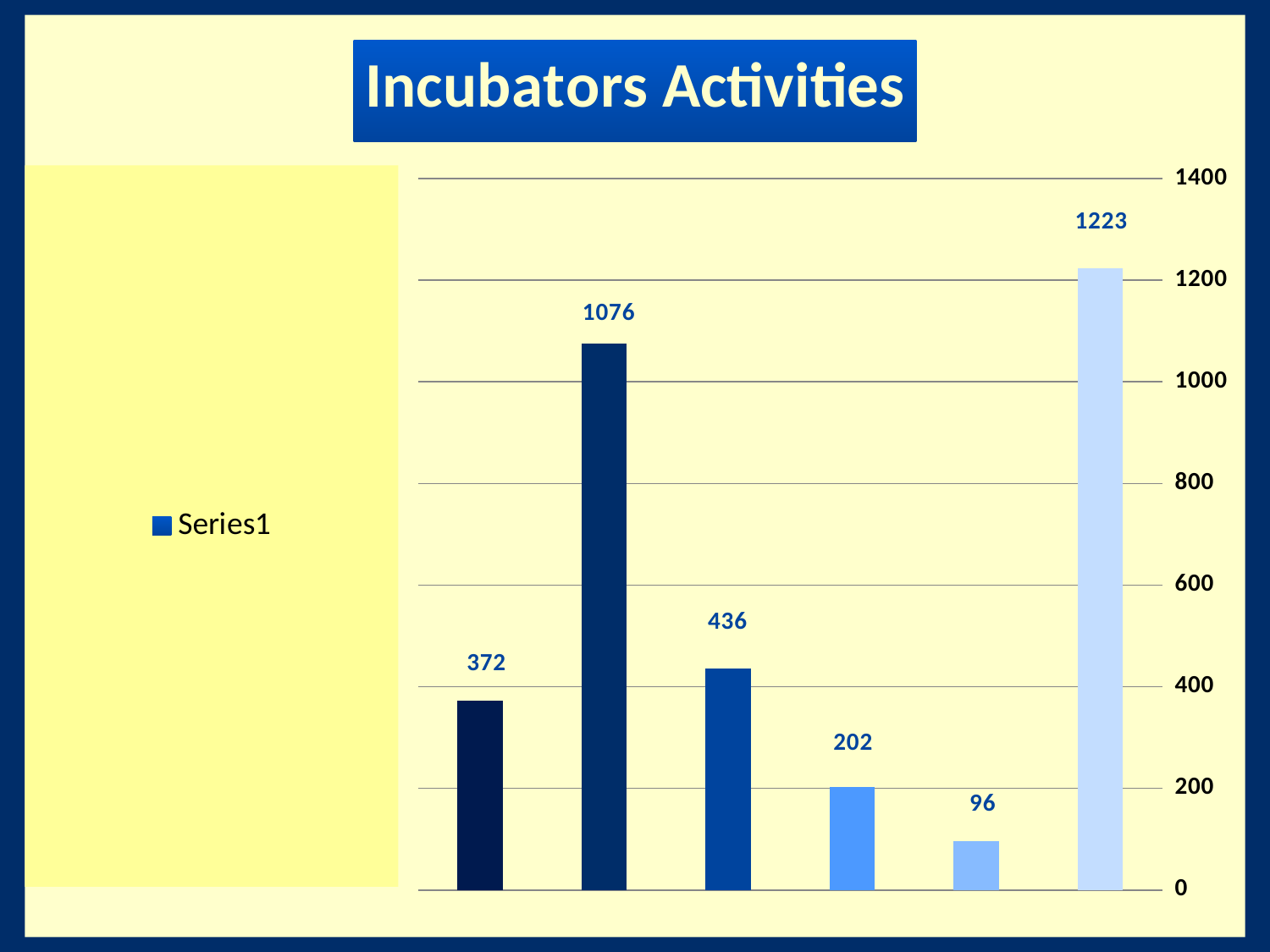
How many bars are plotted in the chart? 6 What is the highest value shown in the chart? 1223 What is the value of the leftmost bar? 372 How many series does the legend list? 1 What is the title of the chart? Incubators Activities What is the lowest value shown in the chart? 96 What is the value of the rightmost bar? 1223 What is the value of the fifth bar from the left? 96 Which is larger, the third bar (436) or the fourth bar (202)? the third bar (436) What type of chart is shown on the slide? bar chart What is the difference between the rightmost bar (1223) and the second bar (1076)? 147 What is the value of the second bar from the left? 1076